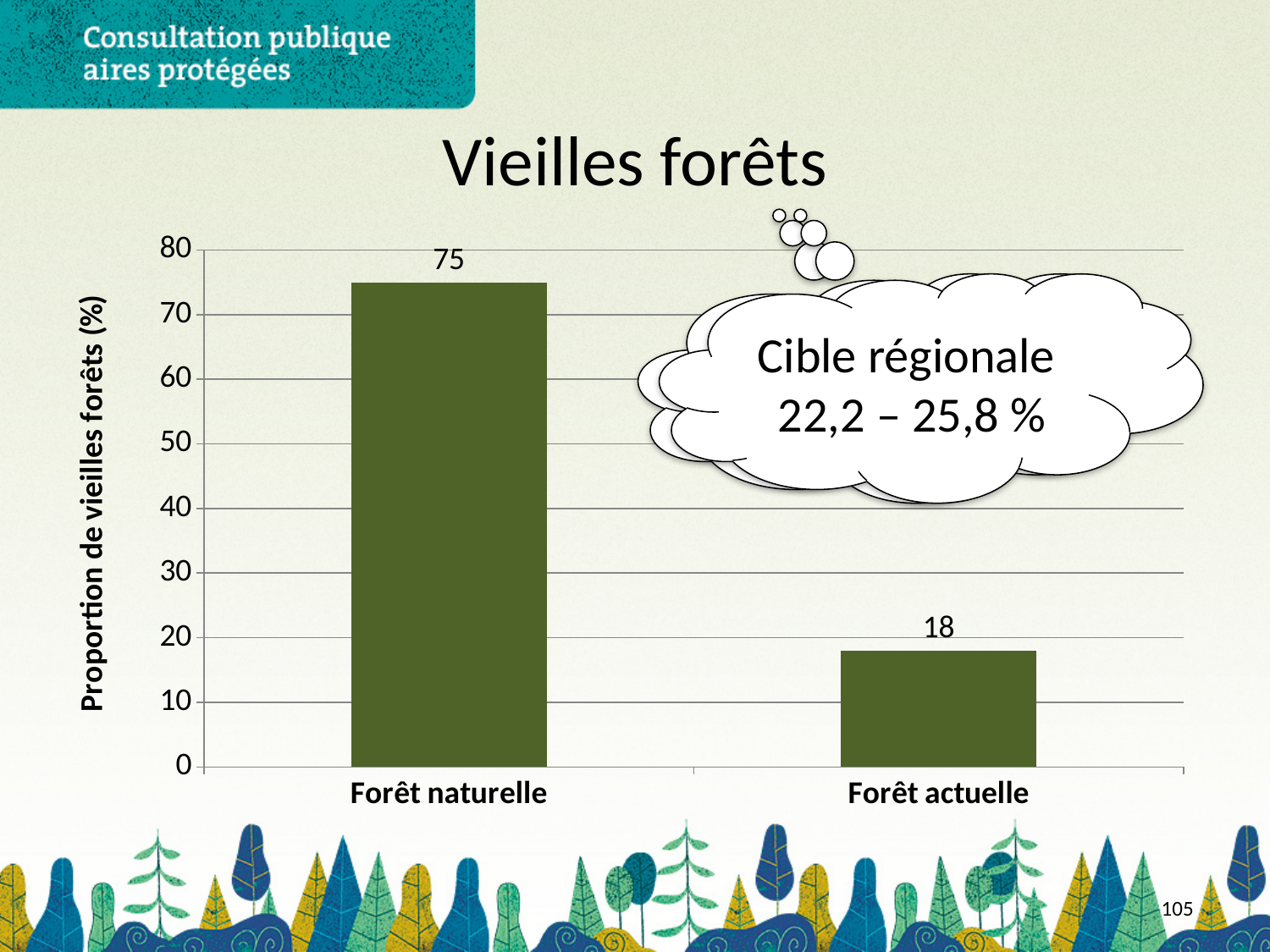
Is the value for Forêt actuelle greater or less than 20? less Which category has the lowest value? Forêt actuelle What is the difference between the values for Forêt naturelle and Forêt actuelle? 57 What kind of chart is shown on the slide? bar chart What is the value for Forêt naturelle? 75 What is the value for Forêt actuelle? 18 How many categories are shown in the chart? 2 What is the title of the chart? Vieilles forêts Which is larger, the value for Forêt naturelle or Forêt actuelle? Forêt naturelle Which category has the highest value? Forêt naturelle What is the label of the vertical axis? Proportion de vieilles forêts (%) Is the value for Forêt naturelle greater or less than 70? greater